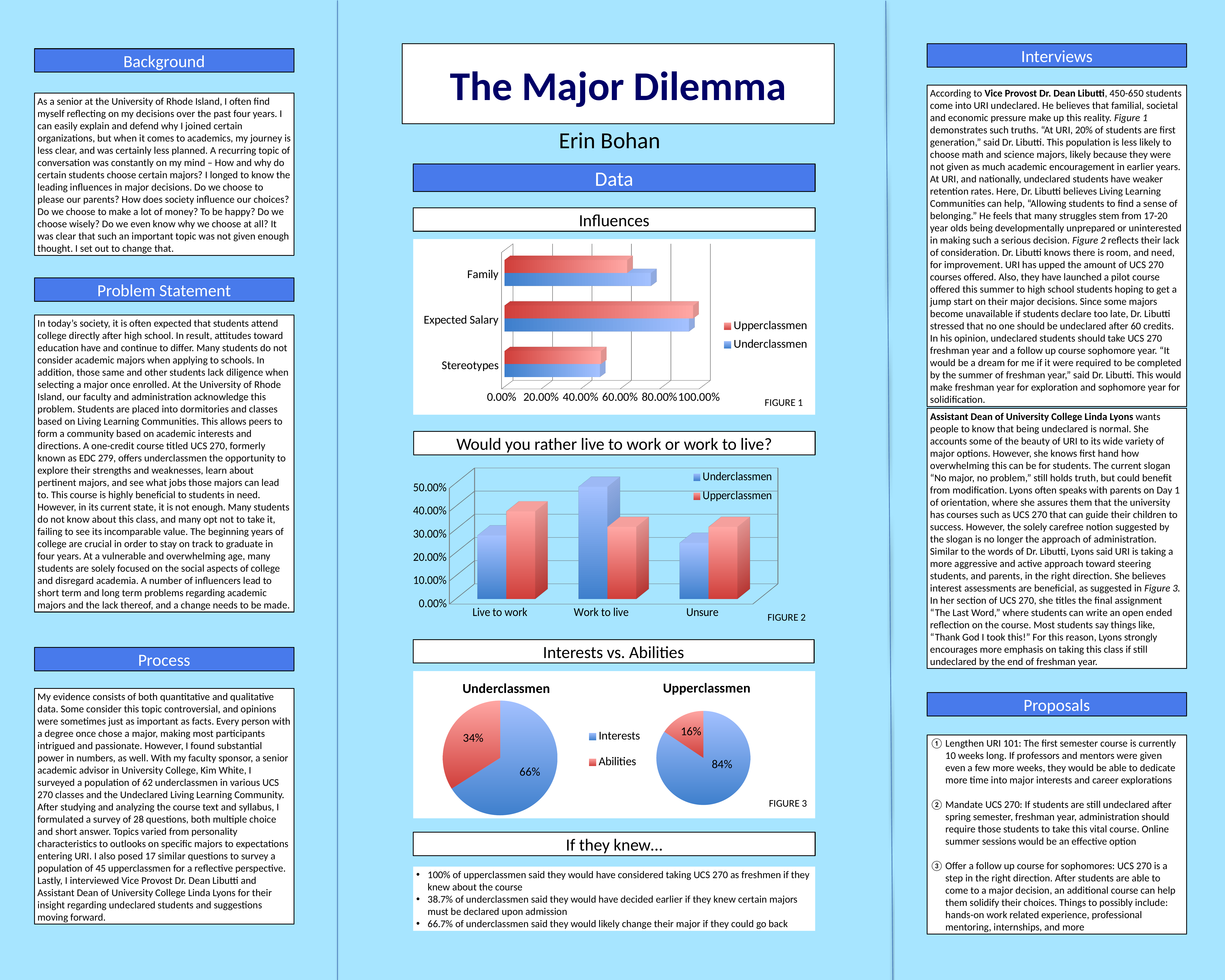
What kind of chart is used in the Interests vs. Abilities figure? Pie chart In the Influences chart, for Family, which series has the larger value, Upperclassmen or Underclassmen? Underclassmen In the Influences chart, which influence has the lowest value for Underclassmen? Stereotypes In the Interests vs. Abilities chart, what is the difference in percentage points between the Interests share for upperclassmen and for underclassmen? 18 percentage points In the Influences chart, is the Underclassmen value for Family greater or less than 60.00%? greater In the Interests vs. Abilities chart, which group has the larger Abilities slice, underclassmen or upperclassmen? Underclassmen In the 'Would you rather live to work or work to live?' chart, which response has the highest value for Underclassmen? Work to live In the Influences chart, which influence has the highest value for Upperclassmen? Expected Salary In the Interests vs. Abilities chart, what share of underclassmen chose Interests? 66% How many categories are shown in the Influences chart? 3 In the Interests vs. Abilities chart, what share of upperclassmen chose Abilities? 16% In the 'Would you rather live to work or work to live?' chart, for Live to work, which series is larger, Underclassmen or Upperclassmen? Upperclassmen